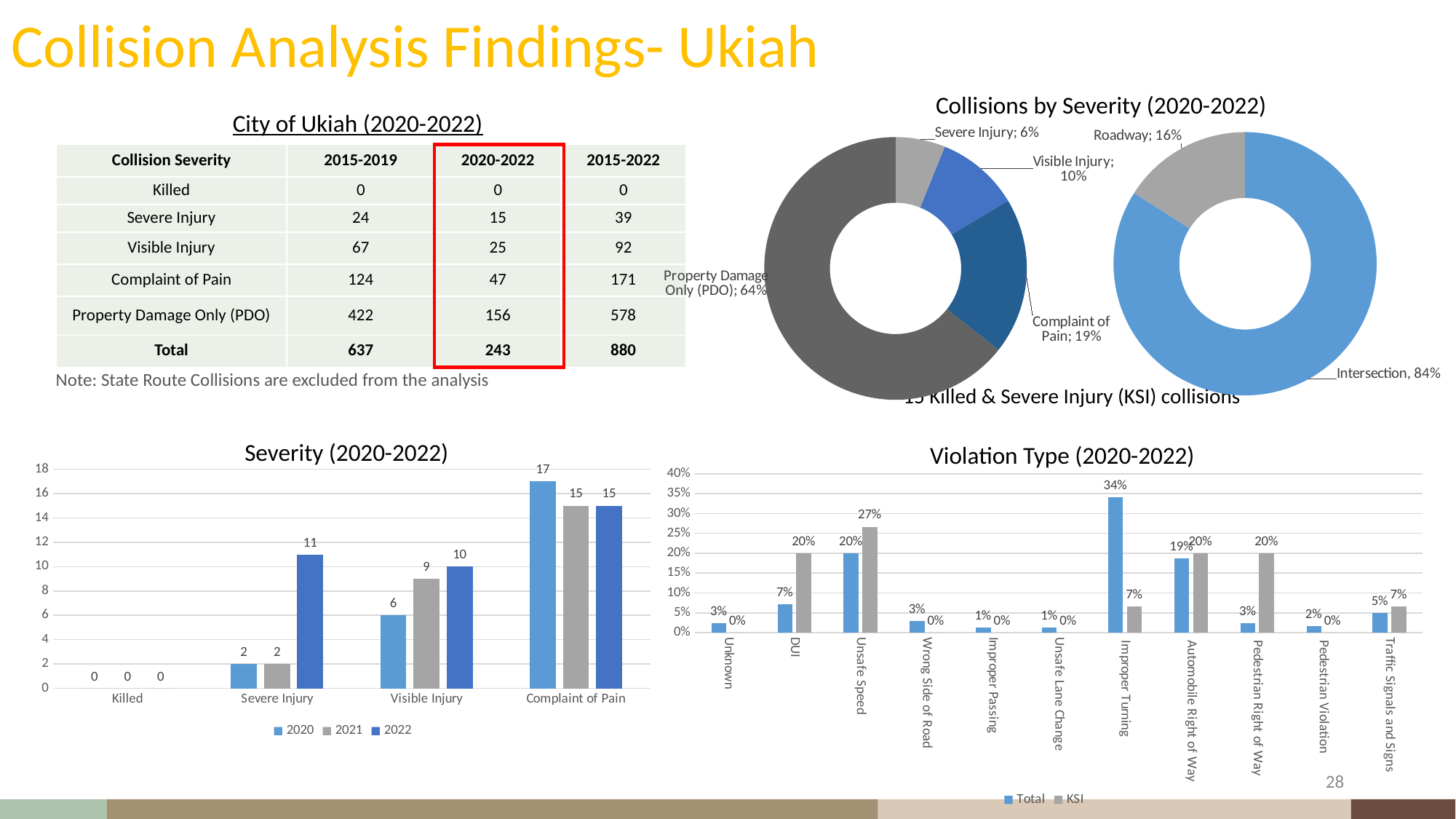
In the 'Severity (2020-2022)' bar chart, what is the difference between Visible Injury in 2022 and Visible Injury in 2020? 4 In the 'Collisions by Severity (2020-2022)' donut chart, which category has the smallest share? Severe Injury In the 'Severity (2020-2022)' bar chart, what is the value for Complaint of Pain in 2020? 17 What kind of chart is 'Violation Type (2020-2022)'? Bar chart In the donut chart on the right showing Roadway and Intersection, what share is Intersection? 84% In the 'Collisions by Severity (2020-2022)' donut chart, what share is Property Damage Only (PDO)? 64% In the 'Violation Type (2020-2022)' bar chart, which violation type has the highest Total value? Improper Turning In the 'Collisions by Severity (2020-2022)' donut chart, what share is Complaint of Pain? 19% In the 'Severity (2020-2022)' bar chart, what is the value for Severe Injury in 2022? 11 In the 'Violation Type (2020-2022)' bar chart, what is the Total value for Improper Turning? 34% In the 'Violation Type (2020-2022)' bar chart, what is the KSI value for Unsafe Speed? 27% In the 'Severity (2020-2022)' bar chart, how many series does the legend list? 3